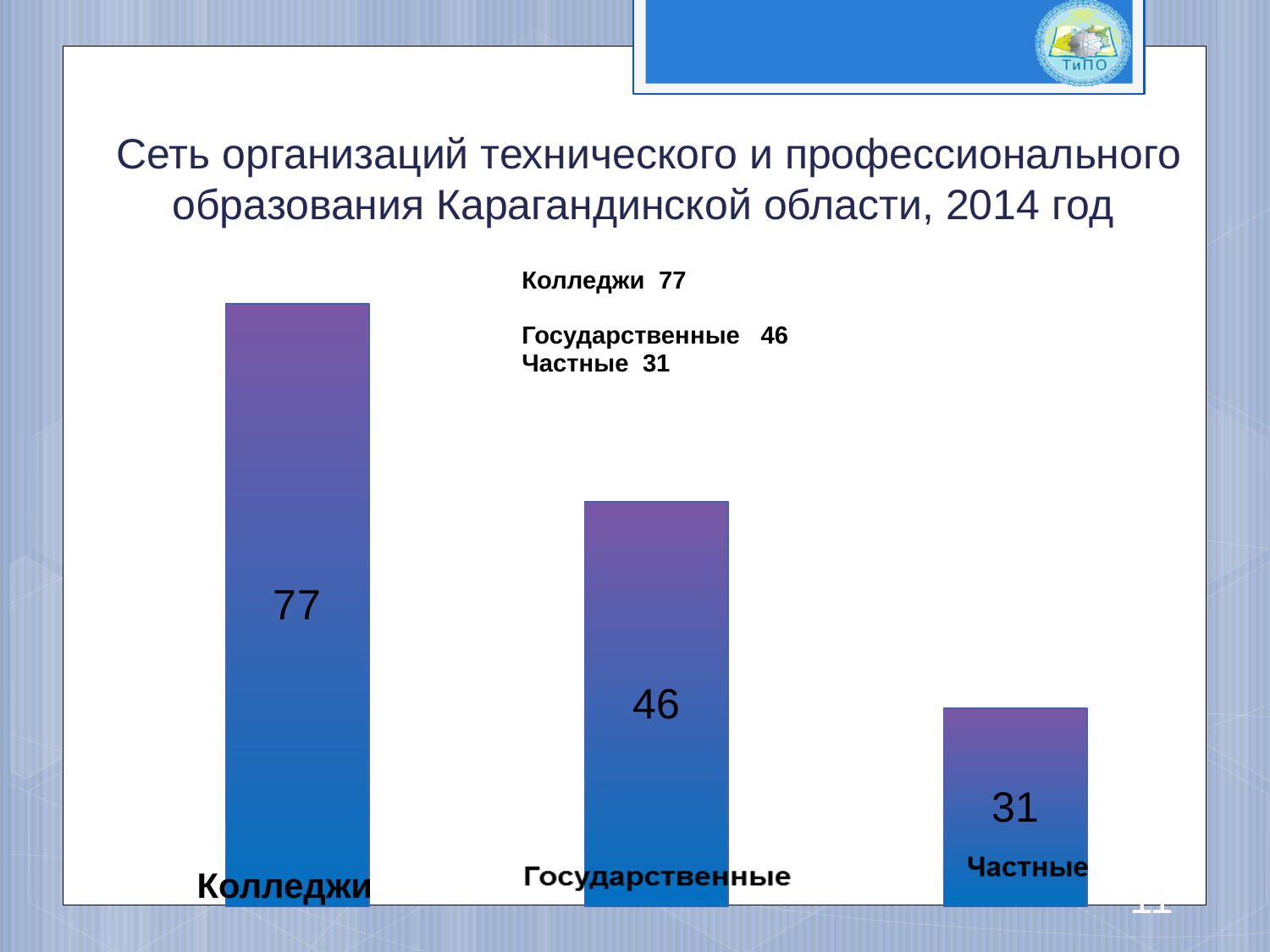
What is the title of the slide containing the chart? Сеть организаций технического и профессионального образования Карагандинской области, 2014 год Which is larger, the value for Государственные or the value for Частные? Государственные How many bars are shown in the chart? 3 What is the difference between the values for Колледжи and Государственные? 31 What is the value for Колледжи? 77 Do the values rise or fall from left to right across the bars? fall What is the value for Государственные? 46 What is the value for Частные? 31 Which category has the highest value? Колледжи Which category has the lowest value? Частные What is the difference between the values for Государственные and Частные? 15 What kind of chart is shown on the slide? bar chart